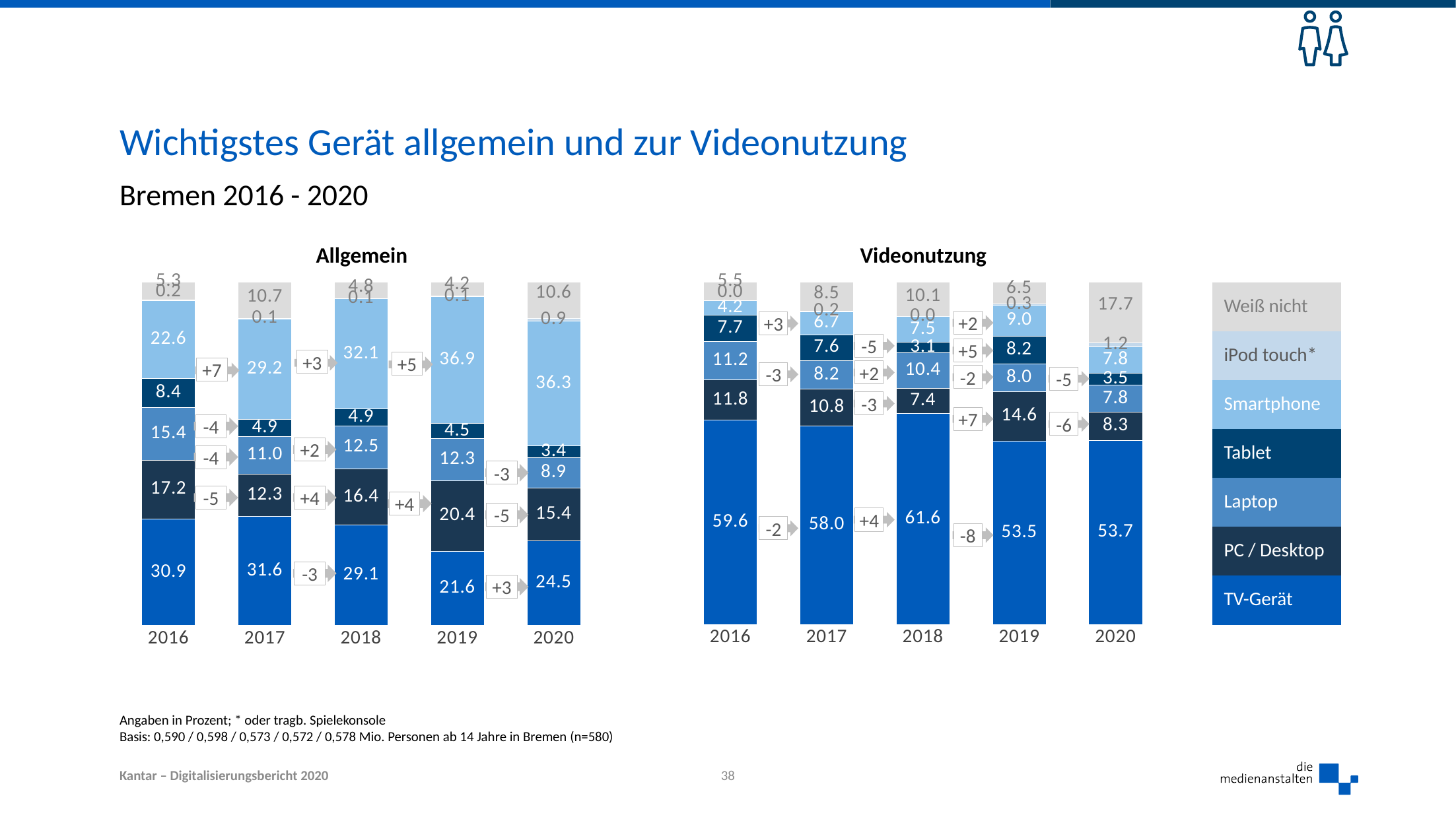
How many years are shown on the x axis of the Videonutzung chart? 5 In the Allgemein chart, in which year is the Smartphone value highest? 2019 In the Videonutzung chart, what is the value for Weiß nicht in 2020? 17.7 In the Allgemein chart, what is the value for Smartphone in 2020? 36.3 What kind of chart is the Allgemein chart? Stacked bar chart In the Videonutzung chart, in which year is the TV-Gerät value lowest? 2019 In the Allgemein chart, what is the value for TV-Gerät in 2016? 30.9 In the Videonutzung chart, what is the value for TV-Gerät in 2018? 61.6 In the Videonutzung chart, what is the difference between the TV-Gerät value in 2018 and in 2019? 8.1 In the Allgemein chart, what is the difference between the Smartphone value in 2019 and in 2016? 14.3 How many series does the legend list? 7 In the Allgemein chart, which is larger in 2019: the TV-Gerät value or the PC / Desktop value? TV-Gerät